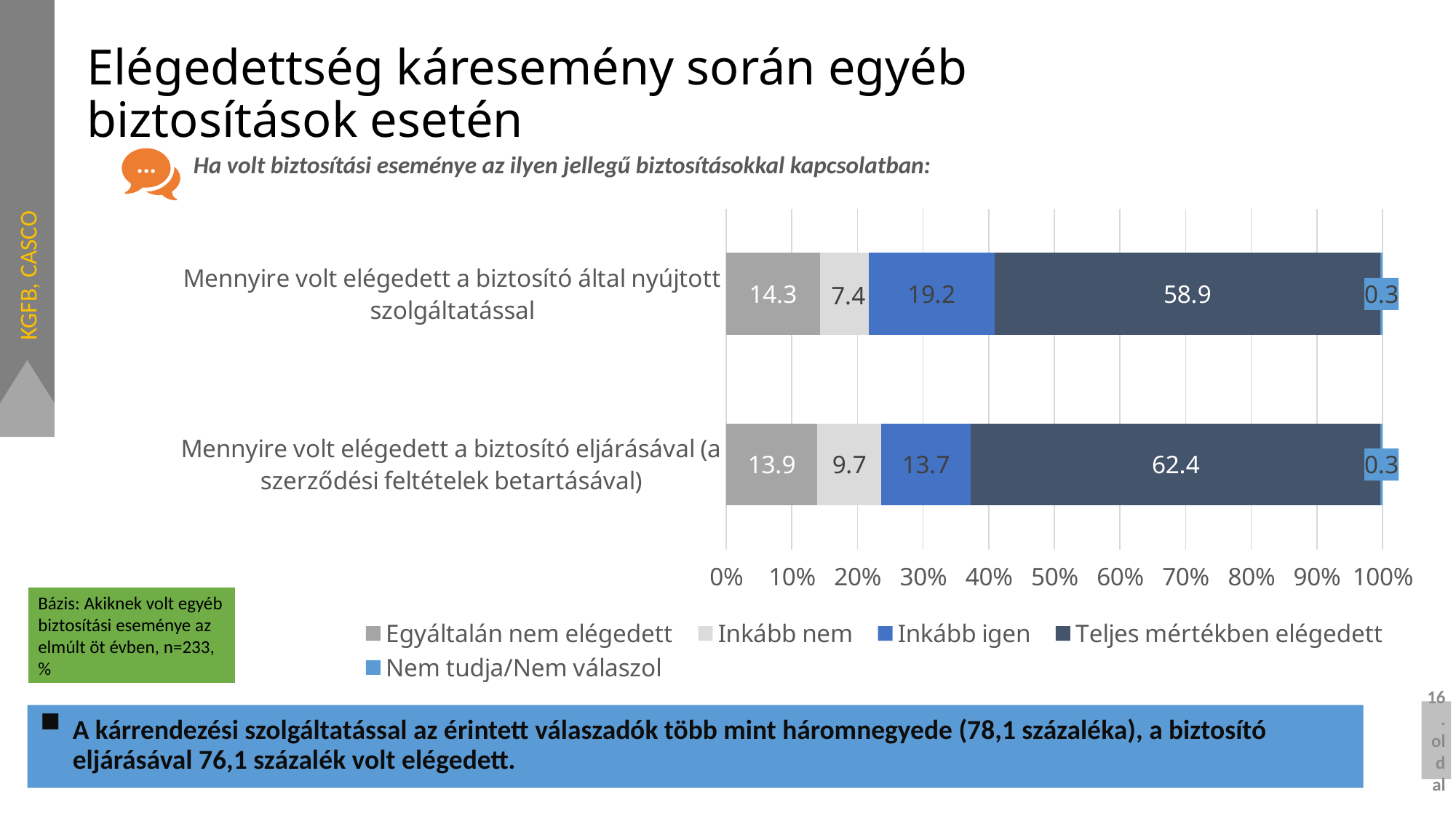
Which series has the smallest segment in the bar "Mennyire volt elégedett a biztosító által nyújtott szolgáltatással"? Nem tudja/Nem válaszol Which bar has the larger "Inkább igen" value? Mennyire volt elégedett a biztosító által nyújtott szolgáltatással What is the value for "Inkább nem" in the bar "Mennyire volt elégedett a biztosító eljárásával (a szerződési feltételek betartásával)"? 9.7 Which series has the largest segment in the bar "Mennyire volt elégedett a biztosító eljárásával (a szerződési feltételek betartásával)"? Teljes mértékben elégedett How many series does the legend list? 5 How many bars (categories) does the chart show? 2 What kind of chart is shown on the slide? Stacked bar chart What is the value for "Nem tudja/Nem válaszol" in the bar "Mennyire volt elégedett a biztosító által nyújtott szolgáltatással"? 0.3 What is the value for "Inkább igen" in the bar "Mennyire volt elégedett a biztosító eljárásával (a szerződési feltételek betartásával)"? 13.7 What is the difference between the "Teljes mértékben elégedett" values of the two bars? 3.5 What is the value for "Egyáltalán nem elégedett" in the bar "Mennyire volt elégedett a biztosító által nyújtott szolgáltatással"? 14.3 What is the value for "Teljes mértékben elégedett" in the bar "Mennyire volt elégedett a biztosító által nyújtott szolgáltatással"? 58.9